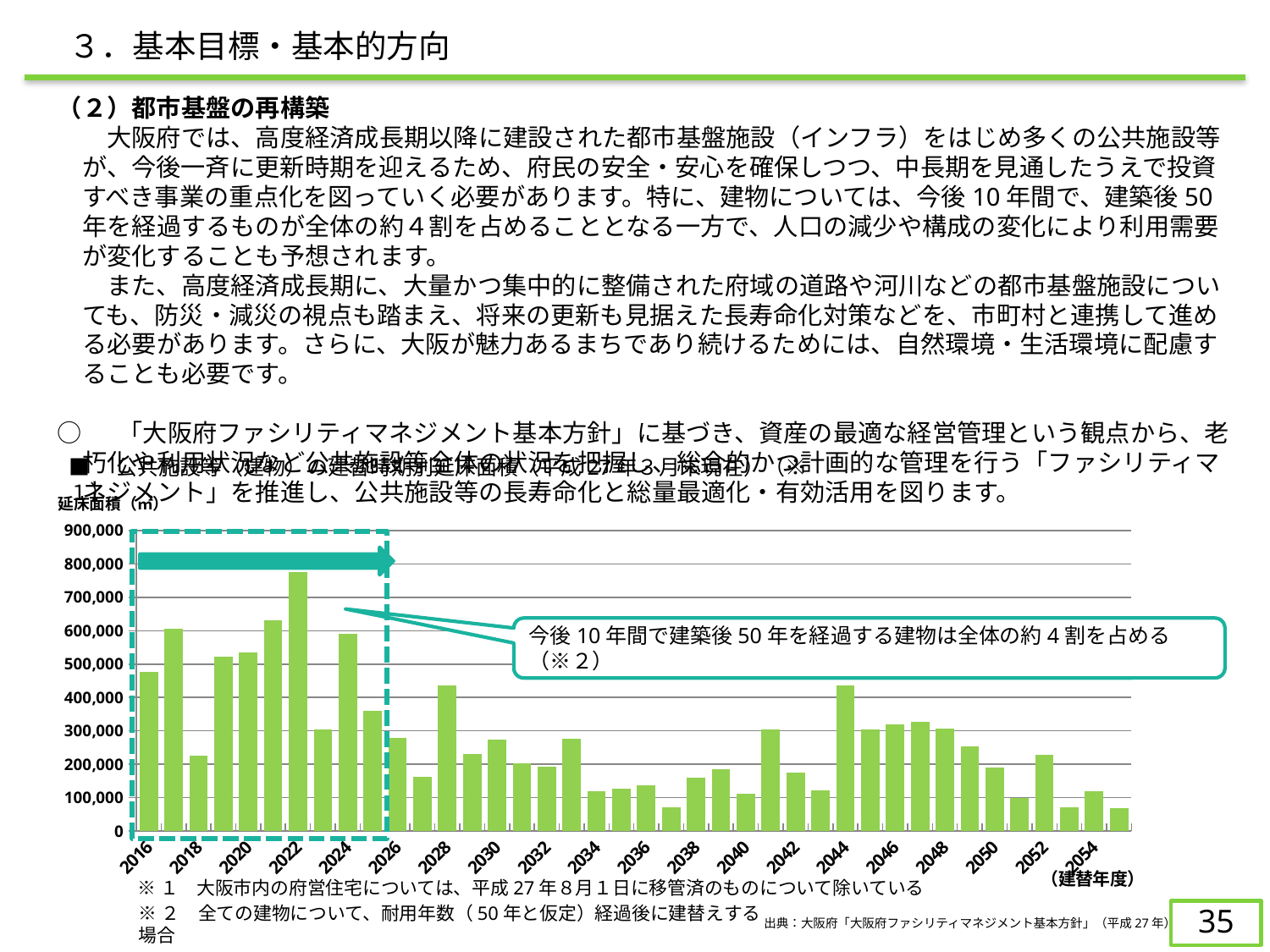
Is the value for 2034 greater or less than 200,000? less Is the value for 2028 greater or less than 400,000? greater What kind of chart is shown on the slide? bar chart What is the highest value shown on the vertical axis of the chart? 900,000 Do the bar values generally rise or fall from 2016 to 2054? fall Which is larger, the value for 2024 or the value for 2026? 2024 What label is shown at the right end of the horizontal axis of the chart? (建替年度) Which is larger, the value for 2017 or the value for 2018? 2017 Is the value for 2044 greater or less than 400,000? greater Which year has the highest bar in the chart? 2022